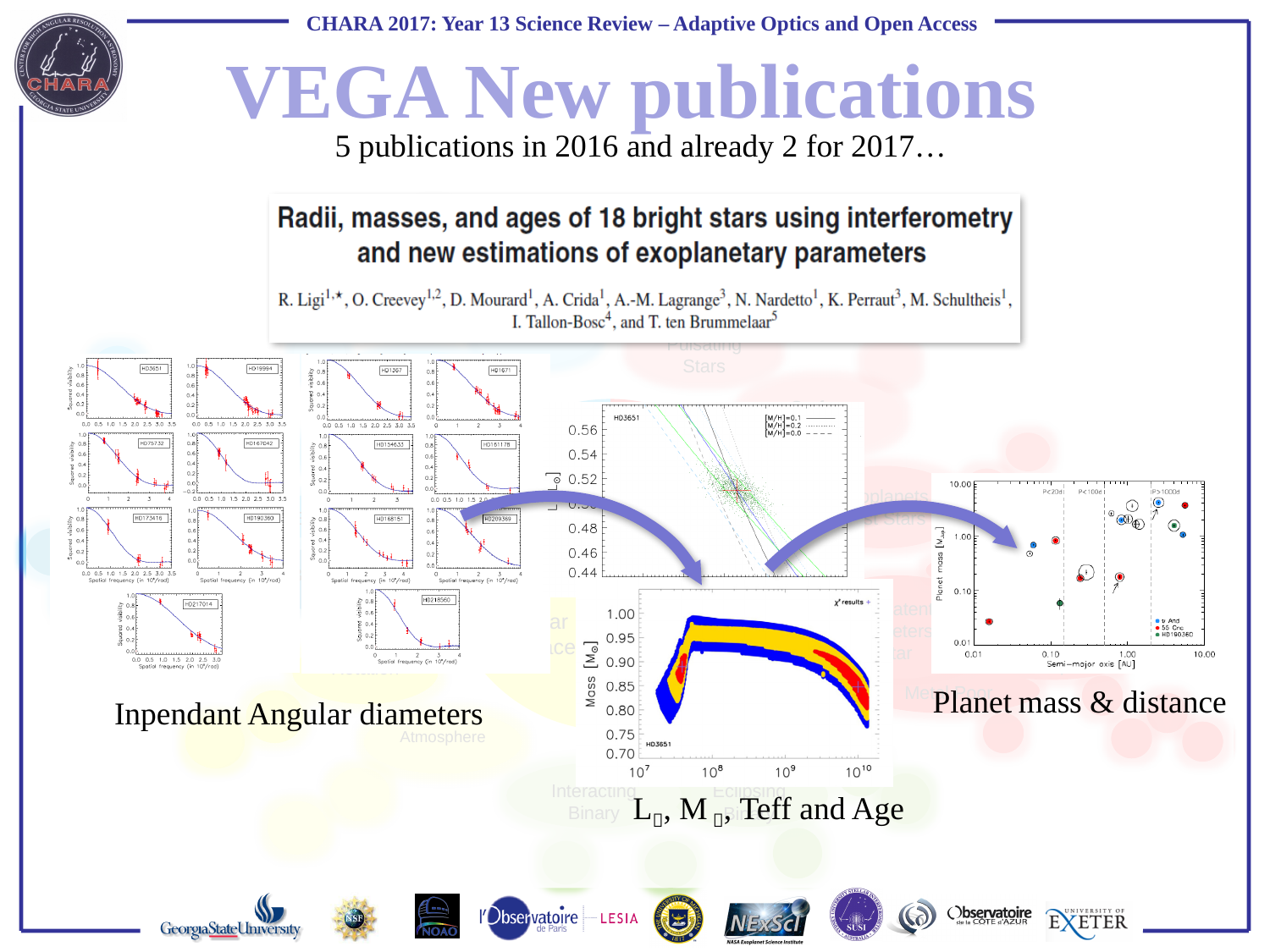
How many metallicity values ([M/H]) are listed in the legend of the HD3651 scatter plot in the centre of the slide? 3 Which three stars are named in the legend of the planet mass versus semi-major axis plot? υ And, 55 Cnc, HD190360 In the planet mass plot, is the semi-major axis of the leftmost point greater or less than 0.10 AU? less How many series does the legend of the planet mass versus semi-major axis plot list? 3 In the planet mass plot, is the lowest-mass 55 Cnc point greater or less than 0.10 Jupiter masses? less What kind of chart is the 'Planet mass & distance' plot on the right of the slide? scatter plot In the planet mass plot, is the HD190360 point near 0.13 AU greater or less than 0.10 Jupiter masses? less In the squared-visibility panels on the left, do the values rise or fall as spatial frequency increases? fall What is the x-axis label of the planet mass plot on the right? Semi-major axis [AU] How many small squared-visibility panels are shown in the 'Inpendant Angular diameters' grid on the left? 14 Which star is labelled in the mass versus age plot at the bottom centre of the slide? HD3651